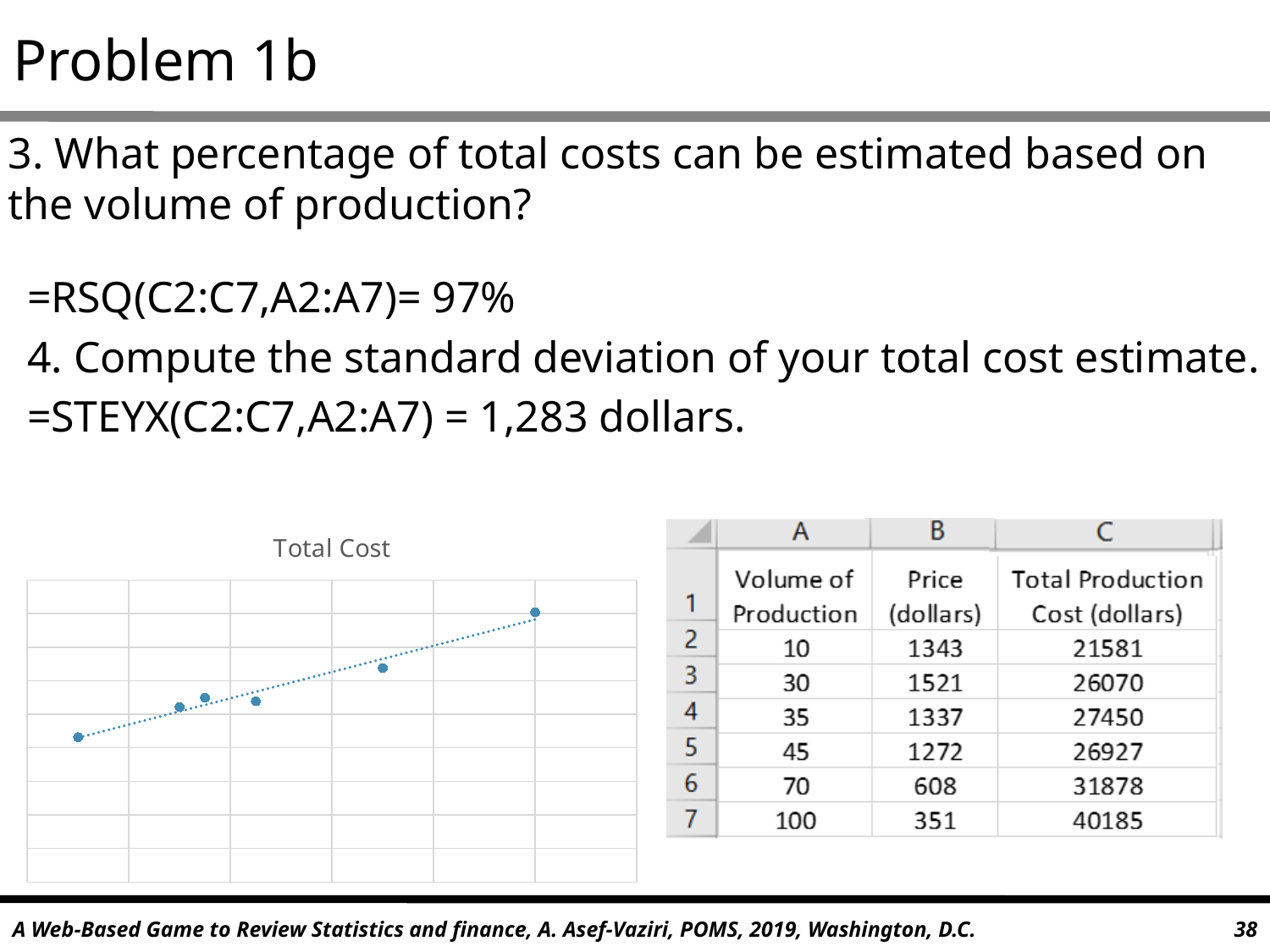
Does the Total Cost chart include a trendline through the points? yes How many data points are plotted in the Total Cost chart? 6 What is the title of the chart on the slide? Total Cost What kind of chart is shown on the slide? scatter chart Do the plotted values in the Total Cost chart generally rise or fall from left to right along the x axis? rise